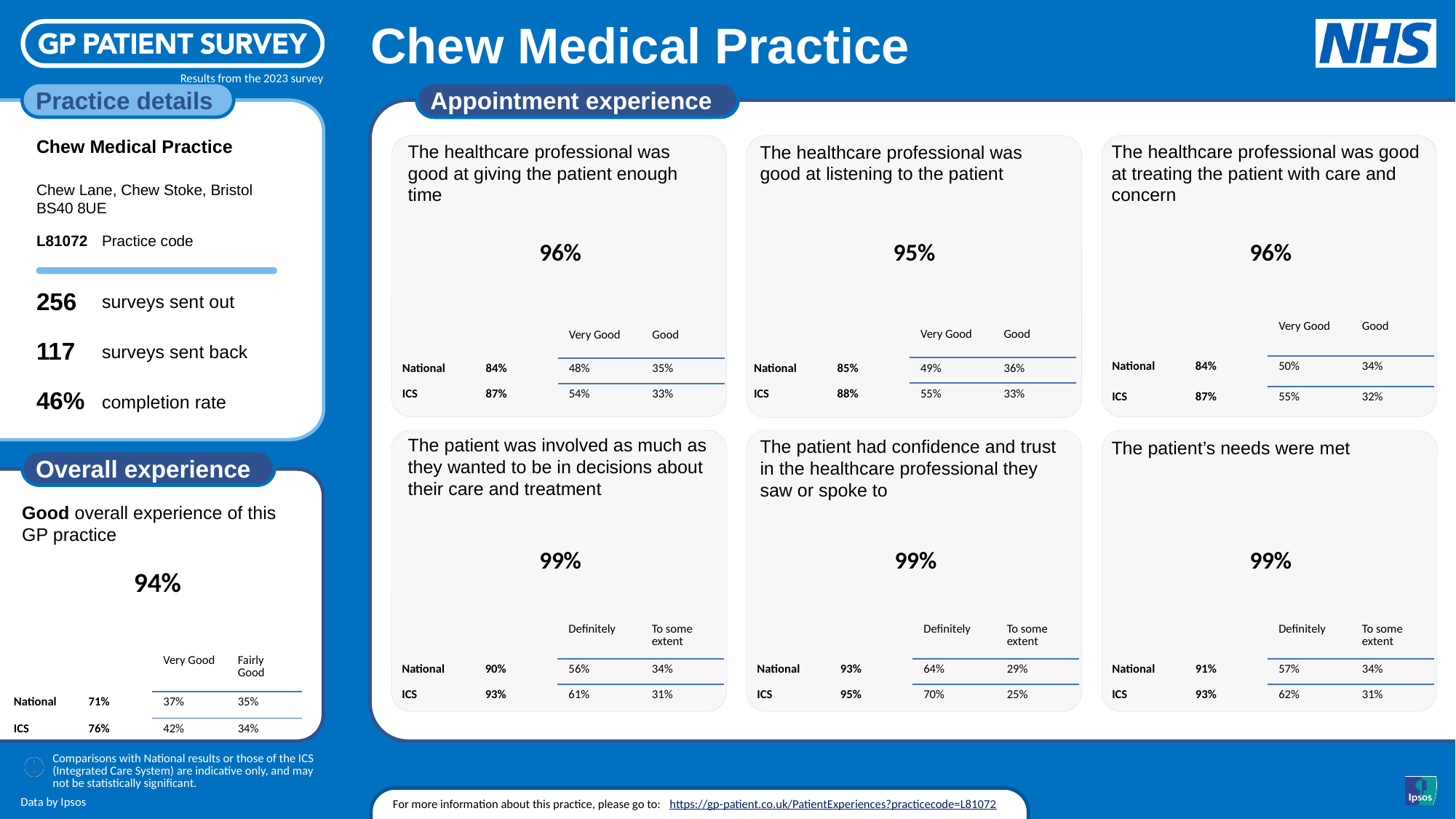
In the 'Overall experience' panel, what is the difference between the practice's 94% and the National 71%? 23 percentage points In the 'Appointment experience' section, what is the ICS figure for 'The healthcare professional was good at giving the patient enough time'? 87% In the 'Appointment experience' section, is the practice's percentage for 'The patient's needs were met' higher or lower than the National figure? higher In the 'Overall experience' panel, what is the National figure for good overall experience? 71% In the 'Appointment experience' section, what is the practice's percentage for 'The healthcare professional was good at listening to the patient'? 95% How many measures are shown in the 'Appointment experience' section? 6 In the 'Appointment experience' section, what is the National 'Very Good' percentage for 'The healthcare professional was good at treating the patient with care and concern'? 50% In the 'Overall experience' panel, what percentage of patients reported a good overall experience of this GP practice? 94% In the 'Appointment experience' section, what are the two response categories shown for 'The patient was involved as much as they wanted to be in decisions about their care and treatment'? Definitely, To some extent In the 'Appointment experience' section, which of the six measures has the lowest practice percentage? The healthcare professional was good at listening to the patient In the 'Appointment experience' section, what is the difference between the ICS and National figures for 'The patient had confidence and trust in the healthcare professional they saw or spoke to'? 2 percentage points In the 'Overall experience' panel, what is the ICS 'Very Good' percentage? 42%